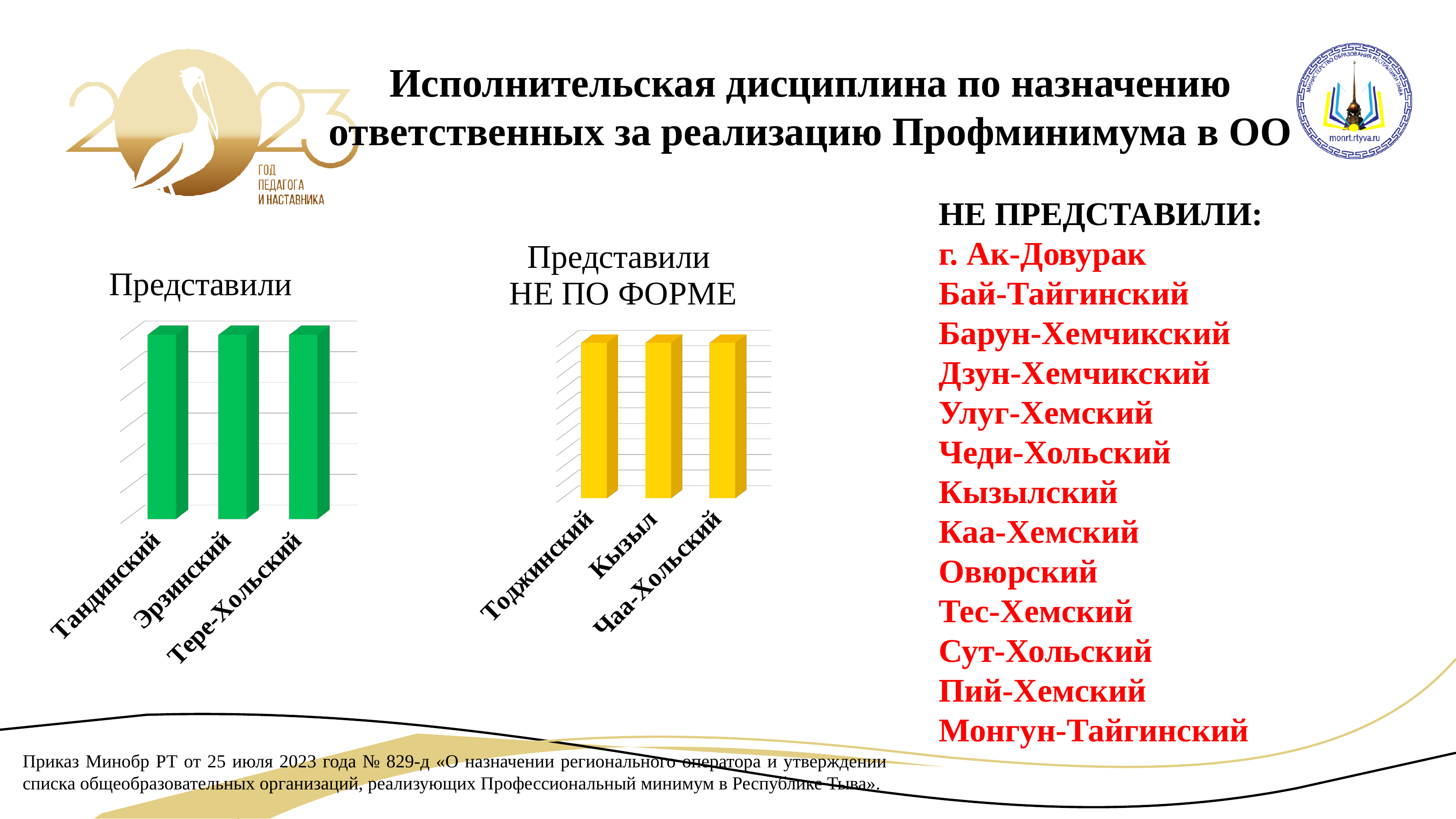
In the chart titled "Представили", which category is shown by the first (leftmost) bar? Тандинский In the chart titled "Представили НЕ ПО ФОРМЕ", do the bar values rise, fall, or stay the same from left to right? stay the same In the chart titled "Представили", do the bar values rise, fall, or stay the same from left to right? stay the same In the chart titled "Представили НЕ ПО ФОРМЕ", which category is shown by the last (rightmost) bar? Чаа-Хольский How many categories are shown in the chart titled "Представили НЕ ПО ФОРМЕ"? 3 How many bar charts are on the slide? 2 What kind of chart is the chart titled "Представили"? bar chart How many categories are shown in the chart titled "Представили"? 3 What kind of chart is the chart titled "Представили НЕ ПО ФОРМЕ"? bar chart